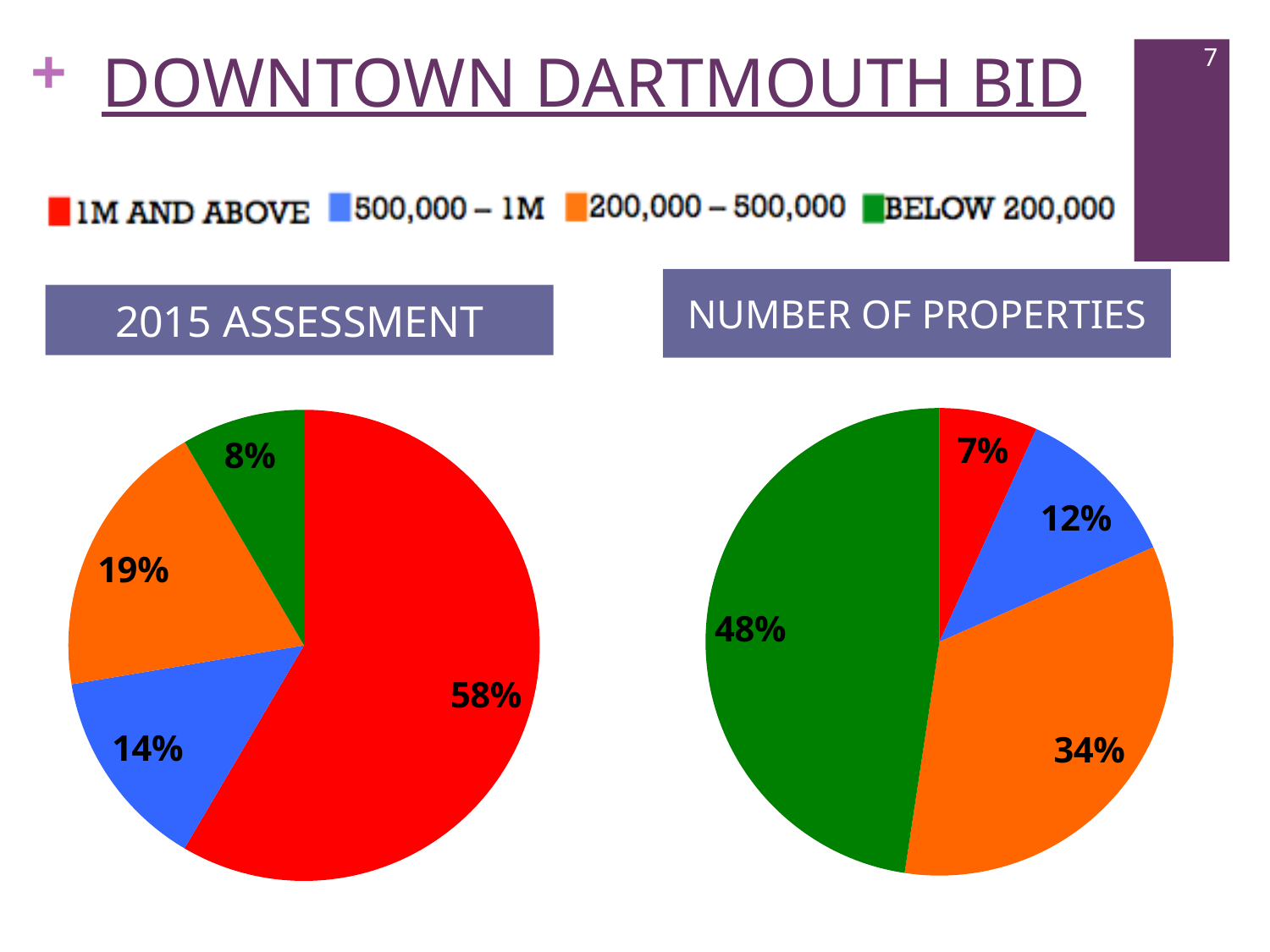
In the 2015 Assessment pie chart, which category has the smallest share? Below 200,000 Which colour represents 1M and above in the legend? Red In the Number of Properties pie chart, what is the difference between the shares for Below 200,000 and 200,000 – 500,000? 14% In the Number of Properties pie chart, which category has the smallest share? 1M and above In the Number of Properties pie chart, what share is shown for 500,000 – 1M? 12% How many categories does the legend list? 4 In the 2015 Assessment pie chart, what share is shown for 200,000 – 500,000? 19% What kind of chart is used for Number of Properties? Pie chart In the Number of Properties pie chart, what share is shown for Below 200,000? 48% In the 2015 Assessment pie chart, what share is shown for 1M and above? 58% In the 2015 Assessment pie chart, which category has the largest share? 1M and above In the 2015 Assessment pie chart, which is larger: the share for 500,000 – 1M or the share for 200,000 – 500,000? 200,000 – 500,000